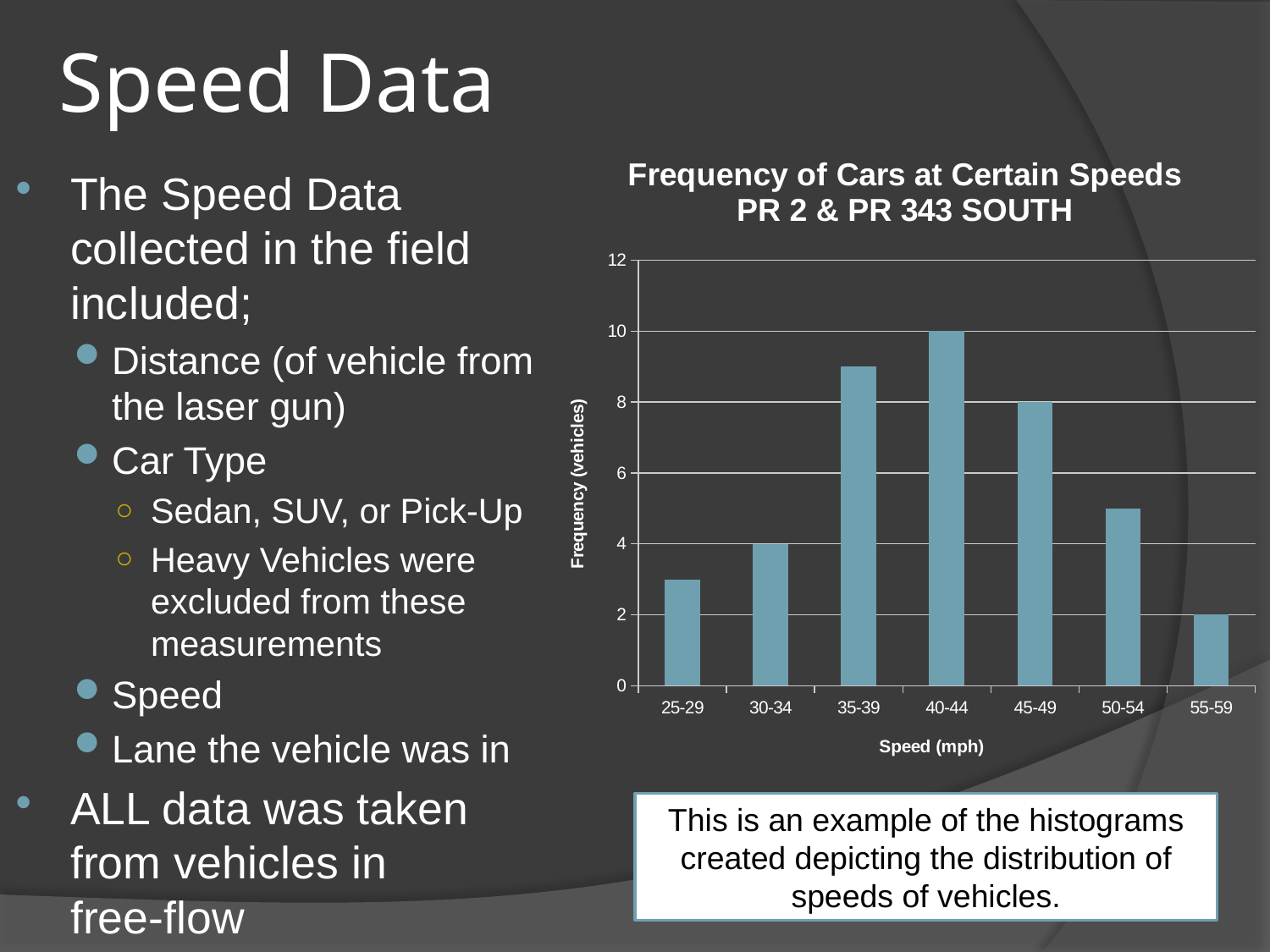
What is the label of the x axis of the chart? Speed (mph) Is the frequency for the 25-29 mph range greater or less than 4? less What is the difference in frequency between the 40-44 and 45-49 mph ranges? 2 Which speed range has the lowest frequency? 55-59 What is the frequency of vehicles in the 45-49 mph range? 8 What type of chart is shown on the slide? bar chart What is the frequency of vehicles in the 30-34 mph range? 4 Is the frequency for the 35-39 mph range greater or less than 8? greater What is the frequency of vehicles in the 40-44 mph range? 10 How many speed categories are shown on the x axis of the chart? 7 Which speed range has the highest frequency? 40-44 What is the frequency of vehicles in the 55-59 mph range? 2